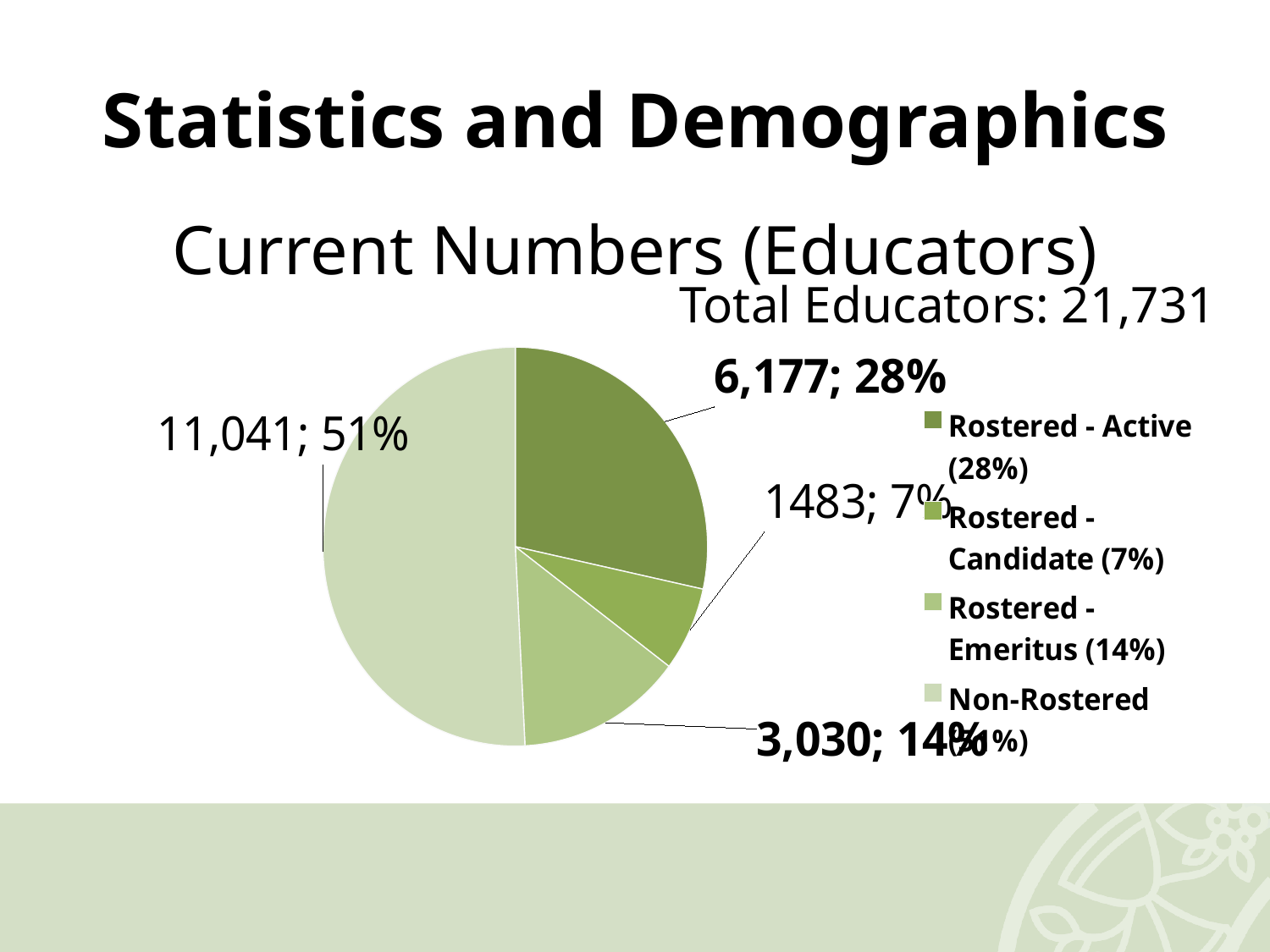
Which is larger, Rostered - Active or Rostered - Emeritus? Rostered - Active What is the value shown for Rostered - Candidate? 1483 How many entries does the legend list? 4 Which category has the smallest slice of the pie? Rostered - Candidate How many slices does the pie chart have? 4 What kind of chart is shown on the slide? pie chart What is the value shown for Non-Rostered? 11,041 Which category has the largest slice of the pie? Non-Rostered What share of the pie does Rostered - Emeritus represent? 14% What is the difference between the Non-Rostered value and the Rostered - Active value? 4,864 What is the value shown for Rostered - Active? 6,177 What is the value shown for Rostered - Emeritus? 3,030